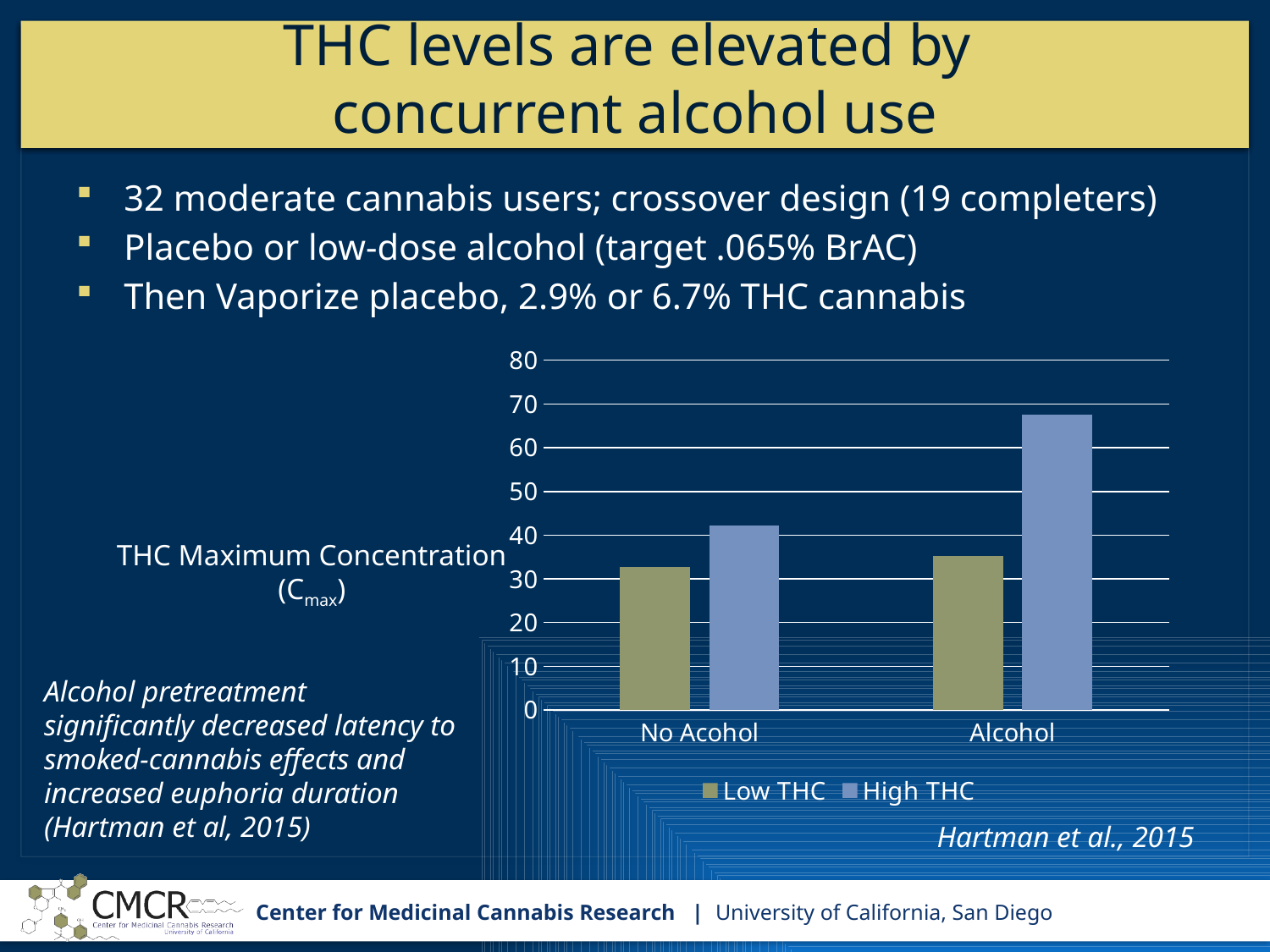
Is the Low THC value for Alcohol greater or less than 40? less What kind of chart is shown on the slide? bar chart Is the Low THC value for No Acohol greater or less than 40? less Which category and series combination has the highest bar in the chart? High THC, Alcohol For High THC, which category has the larger value, No Acohol or Alcohol? Alcohol Is the High THC value for Alcohol greater or less than 60? greater Does the High THC value rise or fall from No Acohol to Alcohol? rise How many series does the chart legend list? 2 What is the title of the chart? THC Maximum Concentration (Cmax) How many categories are shown on the x axis of the chart? 2 What are the two series listed in the chart legend? Low THC and High THC